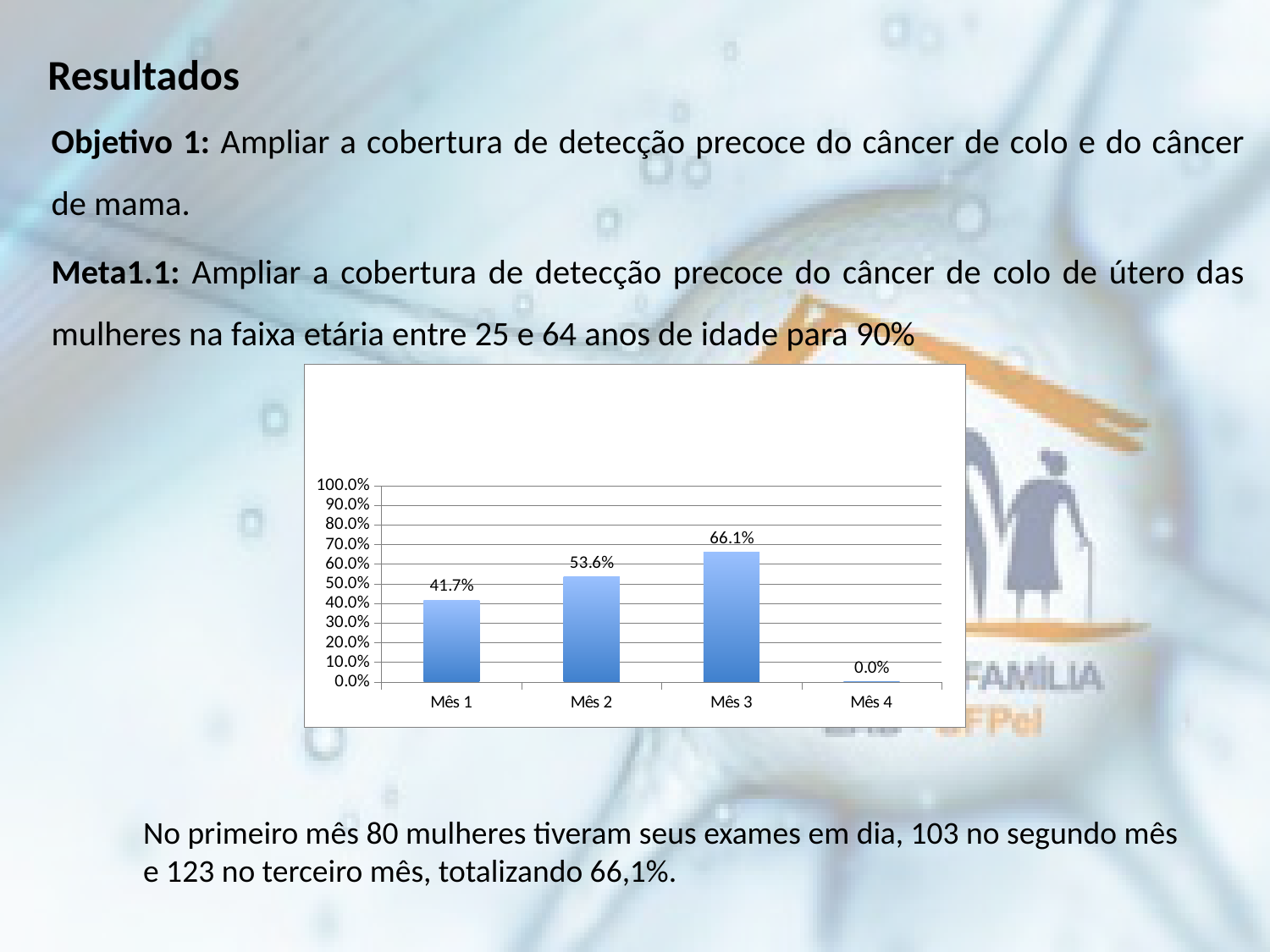
What is the difference between the values for Mês 2 and Mês 1? 11.9% What is the difference between the values for Mês 3 and Mês 1? 24.4% What kind of chart is shown on the slide? bar chart What is the value for Mês 3? 66.1% What is the value for Mês 1? 41.7% Which is larger, the value for Mês 2 or the value for Mês 3? Mês 3 What is the value for Mês 4? 0.0% Is the value for Mês 2 greater or less than 50.0%? greater How many categories are shown on the x axis? 4 What is the value for Mês 2? 53.6% Which category has the highest value? Mês 3 Which category has the lowest value? Mês 4